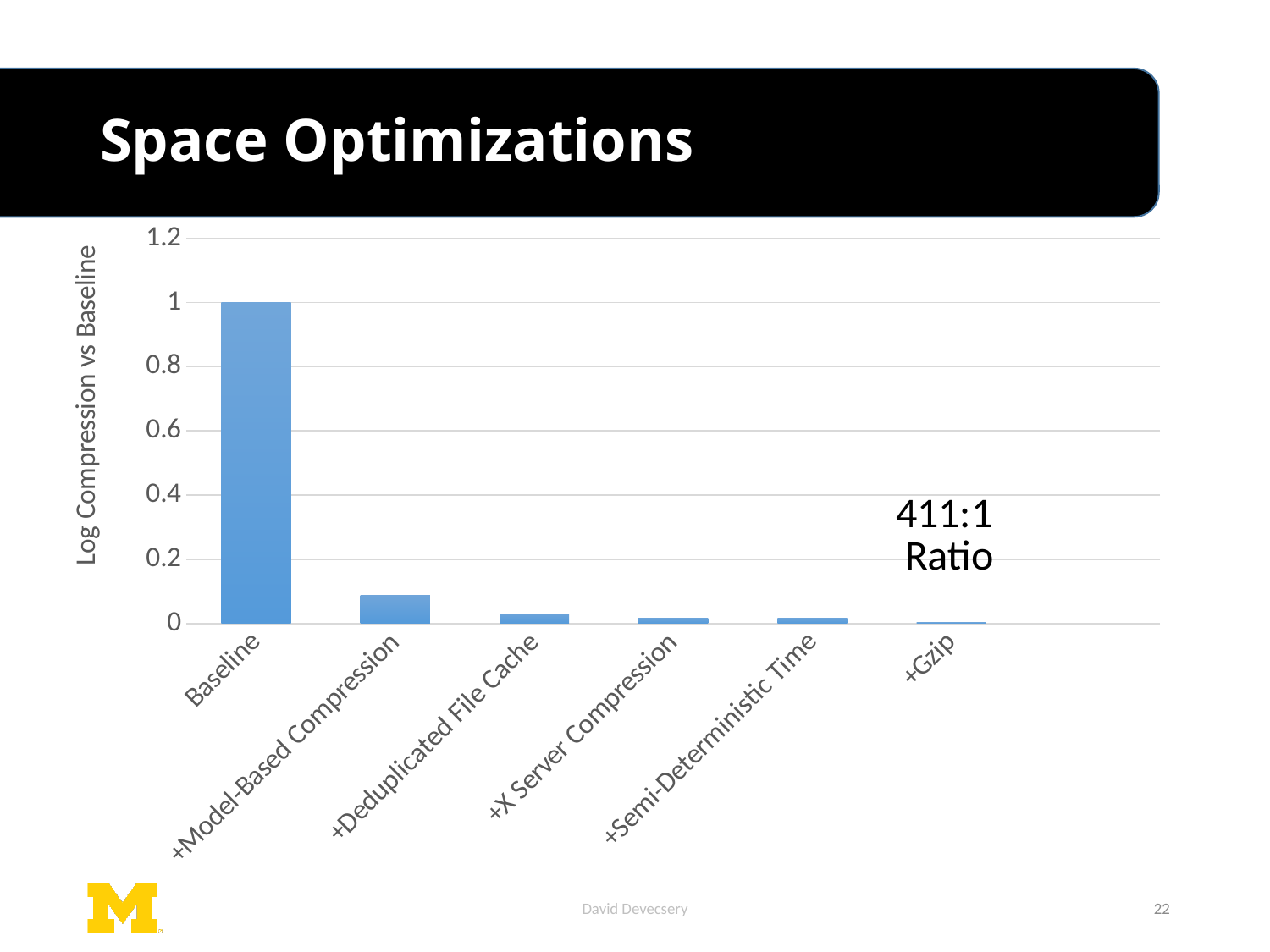
Which is larger, the value for +Model-Based Compression or the value for +Deduplicated File Cache? +Model-Based Compression Which category has the highest bar in the chart? Baseline What ratio is annotated next to the +Gzip bar? 411:1 Ratio How many categories are plotted along the x axis of the chart? 6 Is the value for +Model-Based Compression greater or less than 0.2? less What is the value of the Baseline bar? 1 Which is larger, the value for Baseline or the value for +Model-Based Compression? Baseline What kind of chart is shown on the slide? bar chart Is the value for Baseline greater or less than 0.8? greater What is the label on the y axis of the chart? Log Compression vs Baseline Do the bar values rise or fall moving from left to right along the x axis? fall Which category has the lowest bar in the chart? +Gzip